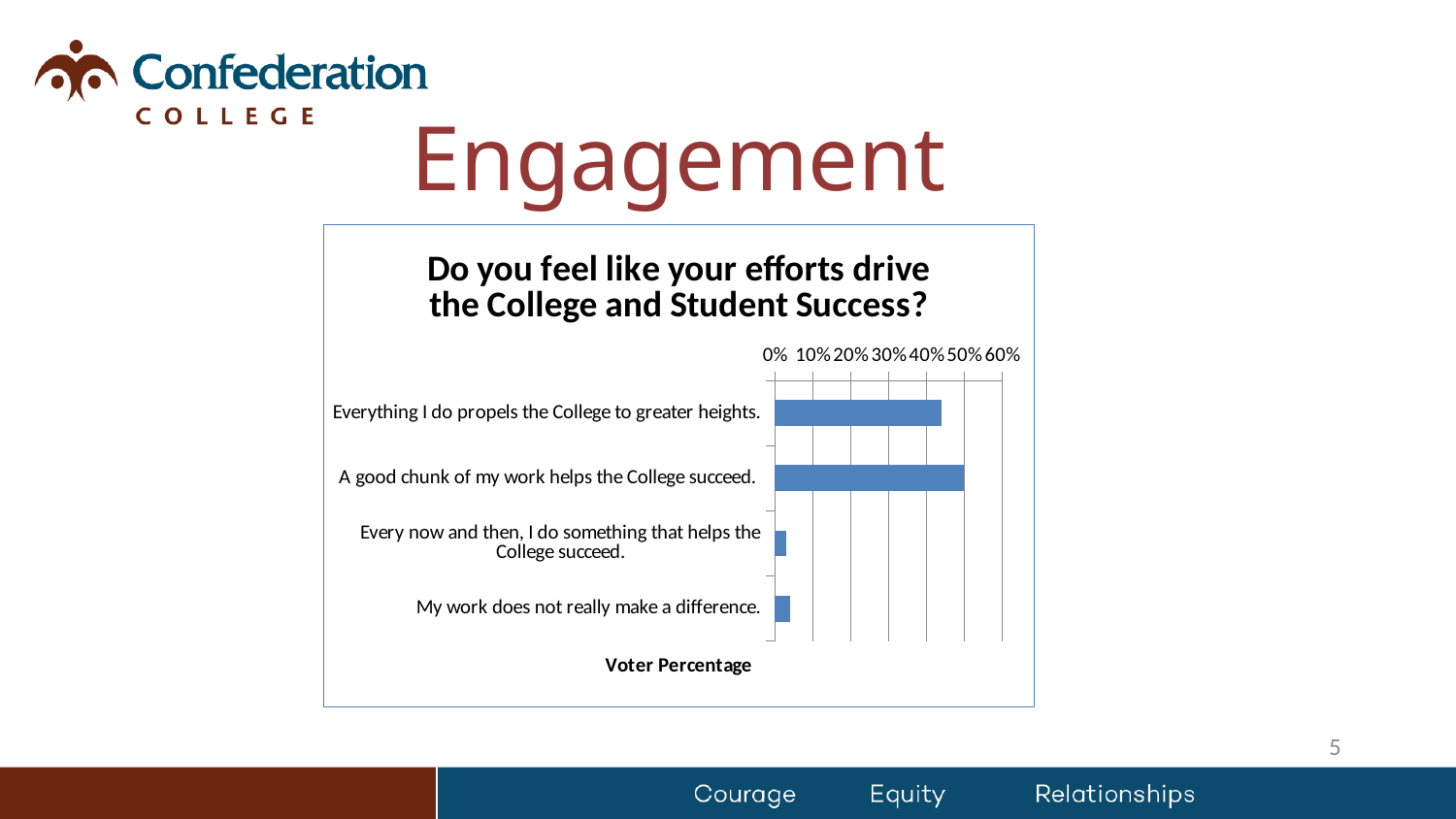
Which response category has the highest voter percentage? A good chunk of my work helps the College succeed. What kind of chart is shown on the slide? bar chart Which is larger: the value for "My work does not really make a difference." or the value for "A good chunk of my work helps the College succeed."? A good chunk of my work helps the College succeed. Is the value for "A good chunk of my work helps the College succeed." greater or less than 40%? greater How many response categories are plotted in the chart? 4 Which is larger: the value for "Everything I do propels the College to greater heights." or the value for "A good chunk of my work helps the College succeed."? A good chunk of my work helps the College succeed. Is the value for "Everything I do propels the College to greater heights." greater or less than 40%? greater Is the value for "Every now and then, I do something that helps the College succeed." greater or less than 10%? less What is the title of the chart? Do you feel like your efforts drive the College and Student Success? What is the label shown beneath the chart's bars? Voter Percentage